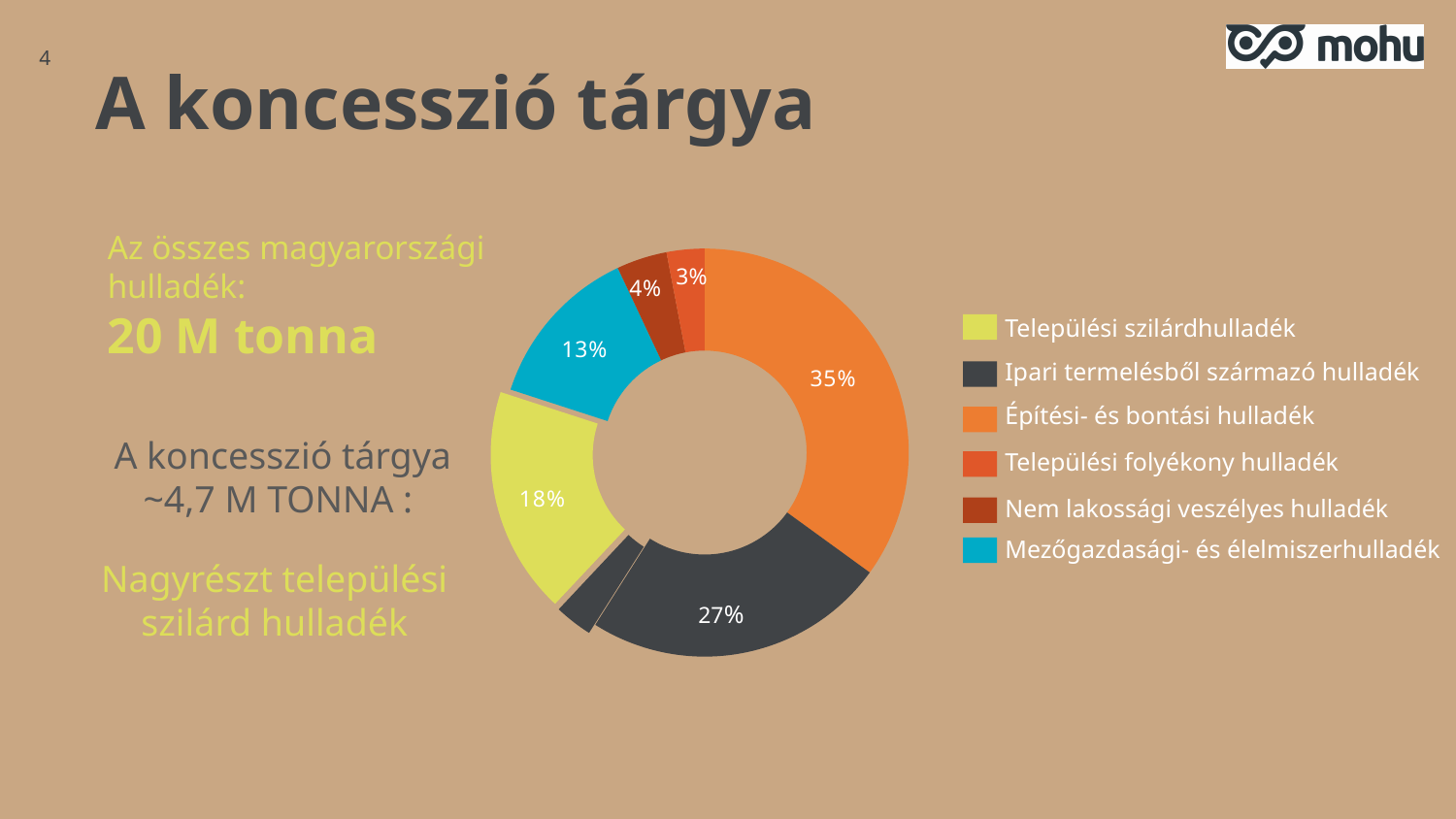
Which category has the smallest share of the pie? Települési folyékony hulladék Which category has the largest share of the pie? Építési- és bontási hulladék What share of the pie is Települési folyékony hulladék? 3% What share of the pie is Ipari termelésből származó hulladék? 27% What colour represents Nem lakossági veszélyes hulladék in the chart? Dark red-brown Which is larger: Települési szilárdhulladék or Mezőgazdasági- és élelmiszerhulladék? Települési szilárdhulladék What is the difference in percentage points between Építési- és bontási hulladék and Ipari termelésből származó hulladék? 8 percentage points What share of the pie is Települési szilárdhulladék? 18% How many categories does the legend list? 6 What share of the pie is Építési- és bontási hulladék? 35% What share of the pie is Mezőgazdasági- és élelmiszerhulladék? 13% What kind of chart is shown on the slide? Pie chart (donut)